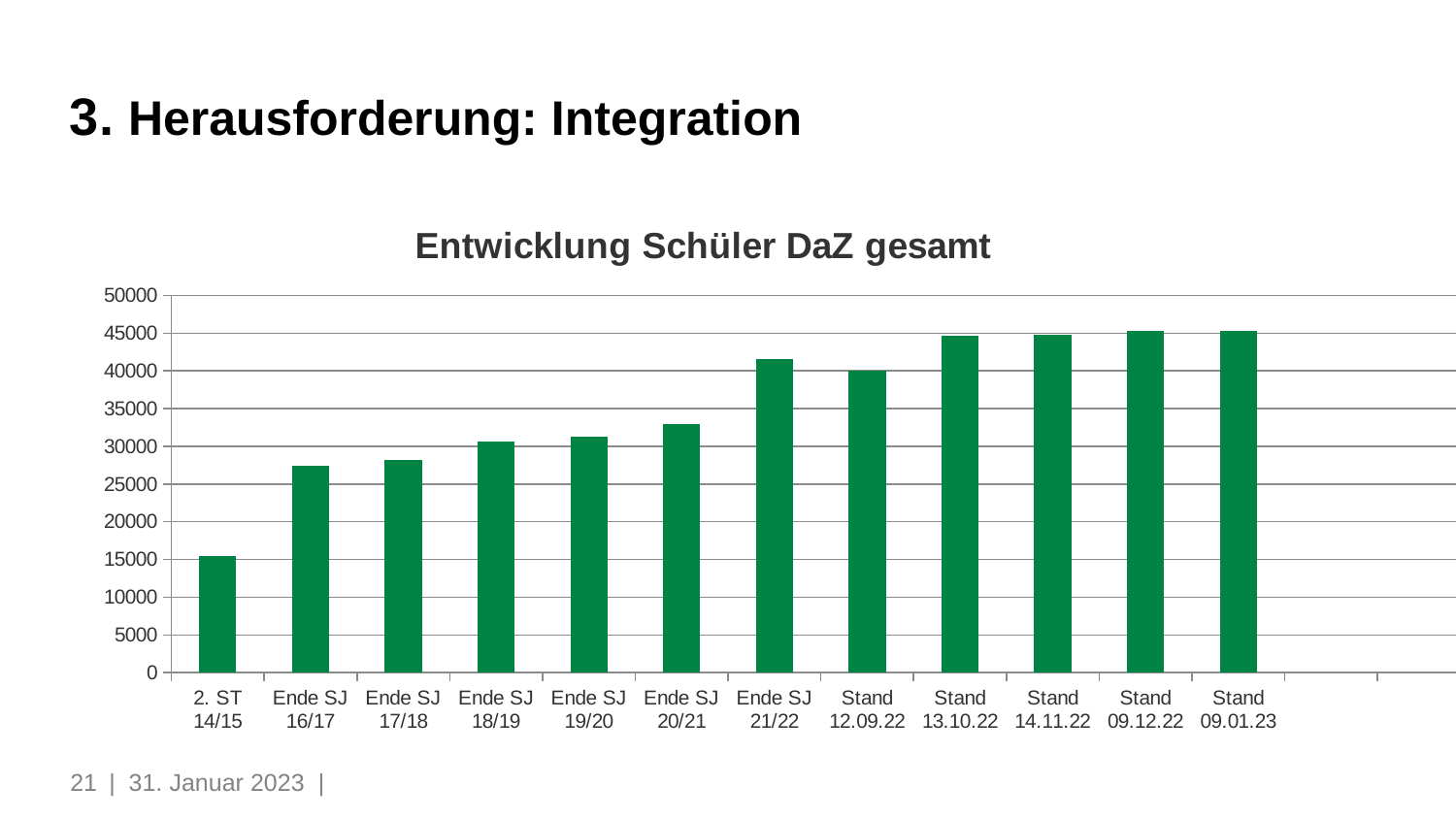
How many bars are plotted in the chart? 12 Is the value for 2. ST 14/15 greater or less than 20000? less Do the values generally rise or fall from 2. ST 14/15 to Stand 09.01.23? rise Which is larger, the value for Ende SJ 21/22 or the value for Stand 12.09.22? Ende SJ 21/22 Is the value for Ende SJ 20/21 greater or less than 35000? less What is the title of the chart? Entwicklung Schüler DaZ gesamt What kind of chart is shown on the slide? bar chart Is the value for Ende SJ 21/22 greater or less than 40000? greater Which is larger, the value for Ende SJ 17/18 or the value for Ende SJ 18/19? Ende SJ 18/19 Which category has the lowest value? 2. ST 14/15